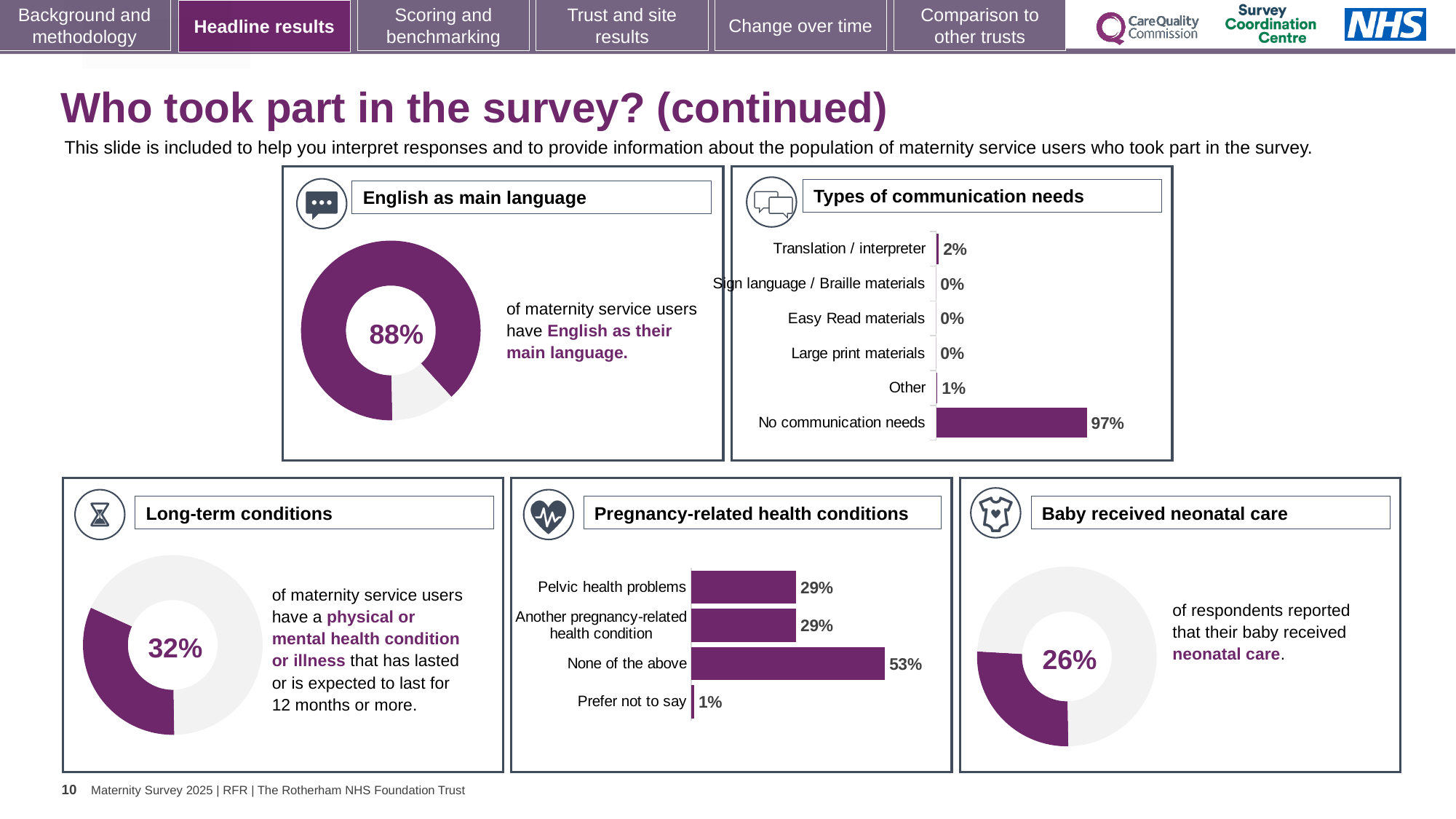
In the 'Types of communication needs' chart, which category has the highest value? No communication needs In the 'Pregnancy-related health conditions' chart, what is the value for 'None of the above'? 53% In the 'Pregnancy-related health conditions' chart, what is the value for 'Pelvic health problems'? 29% What kind of chart is the 'Types of communication needs' chart? Bar chart How many categories are shown in the 'Types of communication needs' chart? 6 In the 'Types of communication needs' chart, what is the value for 'No communication needs'? 97% In the 'English as main language' chart, what percentage of maternity service users have English as their main language? 88% In the 'Pregnancy-related health conditions' chart, which category has the lowest value? Prefer not to say In the 'Types of communication needs' chart, what is the value for 'Translation / interpreter'? 2% In the 'Baby received neonatal care' chart, what percentage of respondents reported that their baby received neonatal care? 26% In the 'Long-term conditions' chart, what percentage of maternity service users have a physical or mental health condition or illness? 32% In the 'Pregnancy-related health conditions' chart, what is the difference between 'None of the above' and 'Pelvic health problems'? 24%